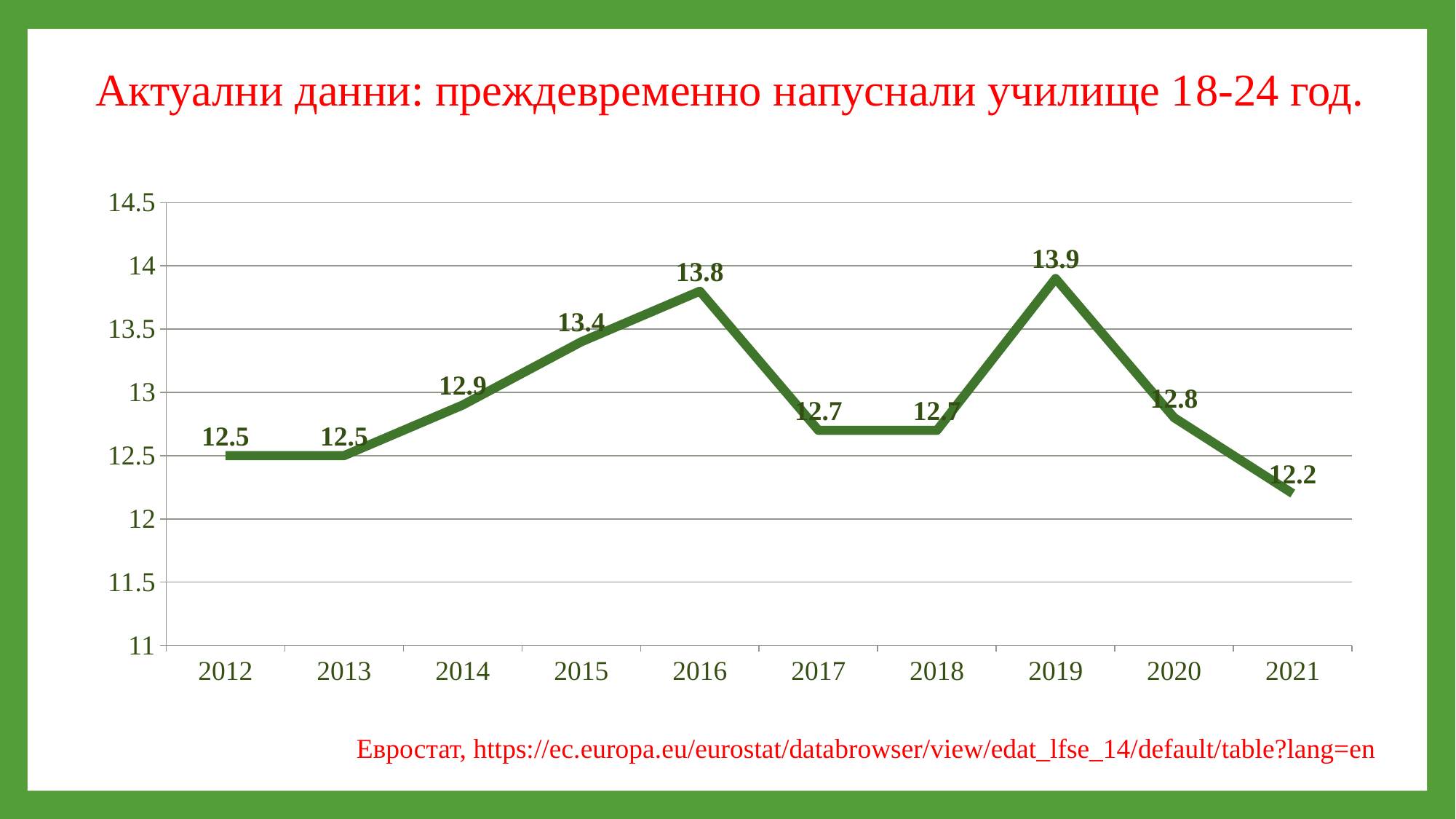
What is the value for 2016? 13.8 What is the value for 2014? 12.9 Do the values rise or fall from 2019 to 2021? fall Is the value for 2019 greater or less than 13.5? greater What is the difference between the values for 2016 and 2017? 1.1 How many years are plotted on the x axis? 10 Which is larger, the value for 2015 or the value for 2020? 2015 What is the value for 2021? 12.2 What kind of chart is shown on the slide? line chart Which year has the highest value? 2019 What is the difference between the values for 2019 and 2021? 1.7 Which year has the lowest value? 2021